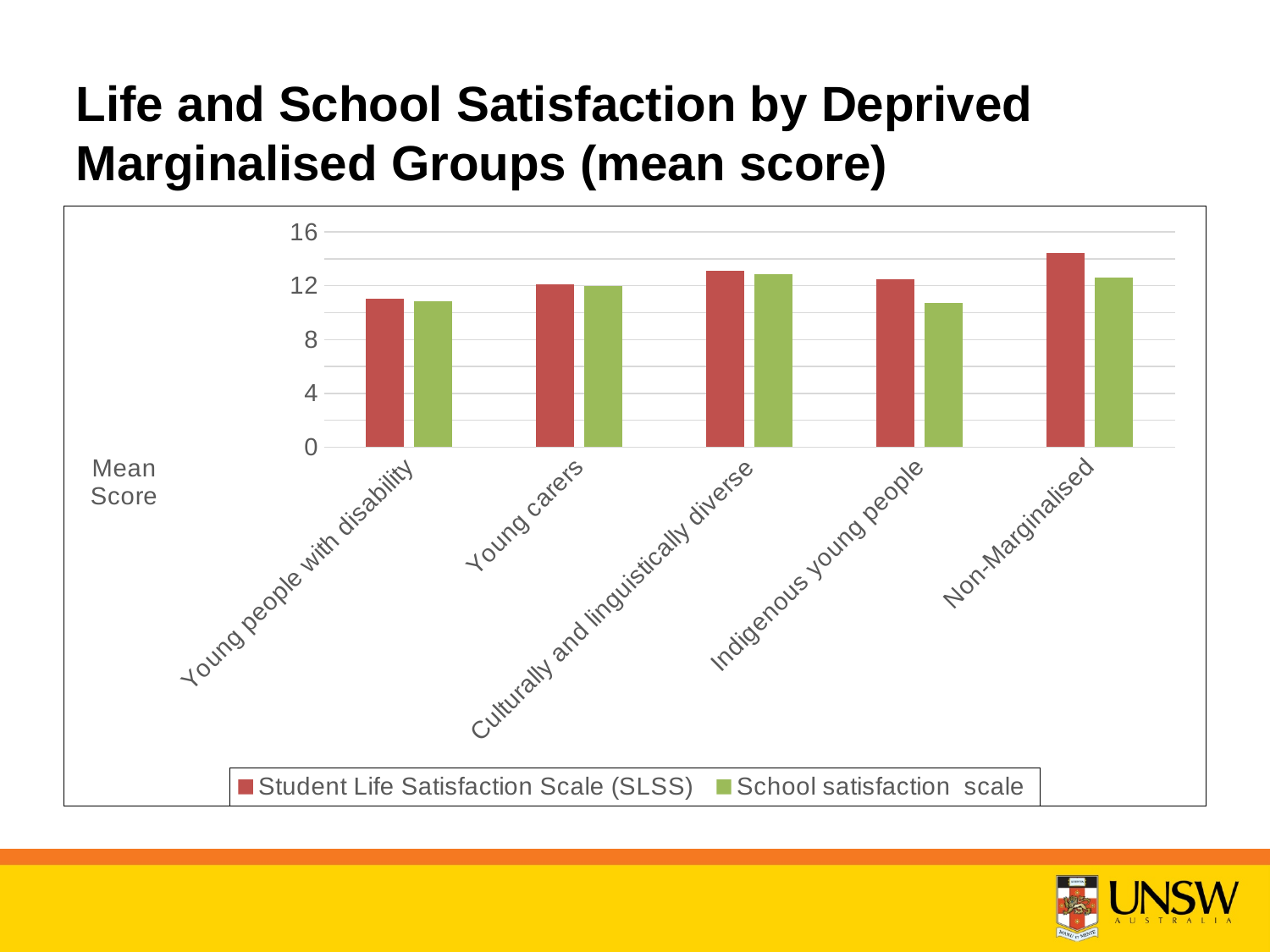
Is the Student Life Satisfaction Scale (SLSS) value for Young people with disability greater or less than 12? less Which group has the highest Student Life Satisfaction Scale (SLSS) score? Non-Marginalised Which group has the lowest Student Life Satisfaction Scale (SLSS) score? Young people with disability Is the Student Life Satisfaction Scale (SLSS) value for Non-Marginalised greater or less than 12? greater How many marginalised groups (categories) are shown on the x axis? 5 Is the Student Life Satisfaction Scale (SLSS) value for Culturally and linguistically diverse greater or less than 12? greater Which colour represents the School satisfaction scale series? Green How many series does the legend list? 2 For Indigenous young people, which is larger: the Student Life Satisfaction Scale (SLSS) score or the School satisfaction scale score? Student Life Satisfaction Scale (SLSS) What kind of chart is shown on the slide? Bar chart For Non-Marginalised, which is larger: the Student Life Satisfaction Scale (SLSS) score or the School satisfaction scale score? Student Life Satisfaction Scale (SLSS)